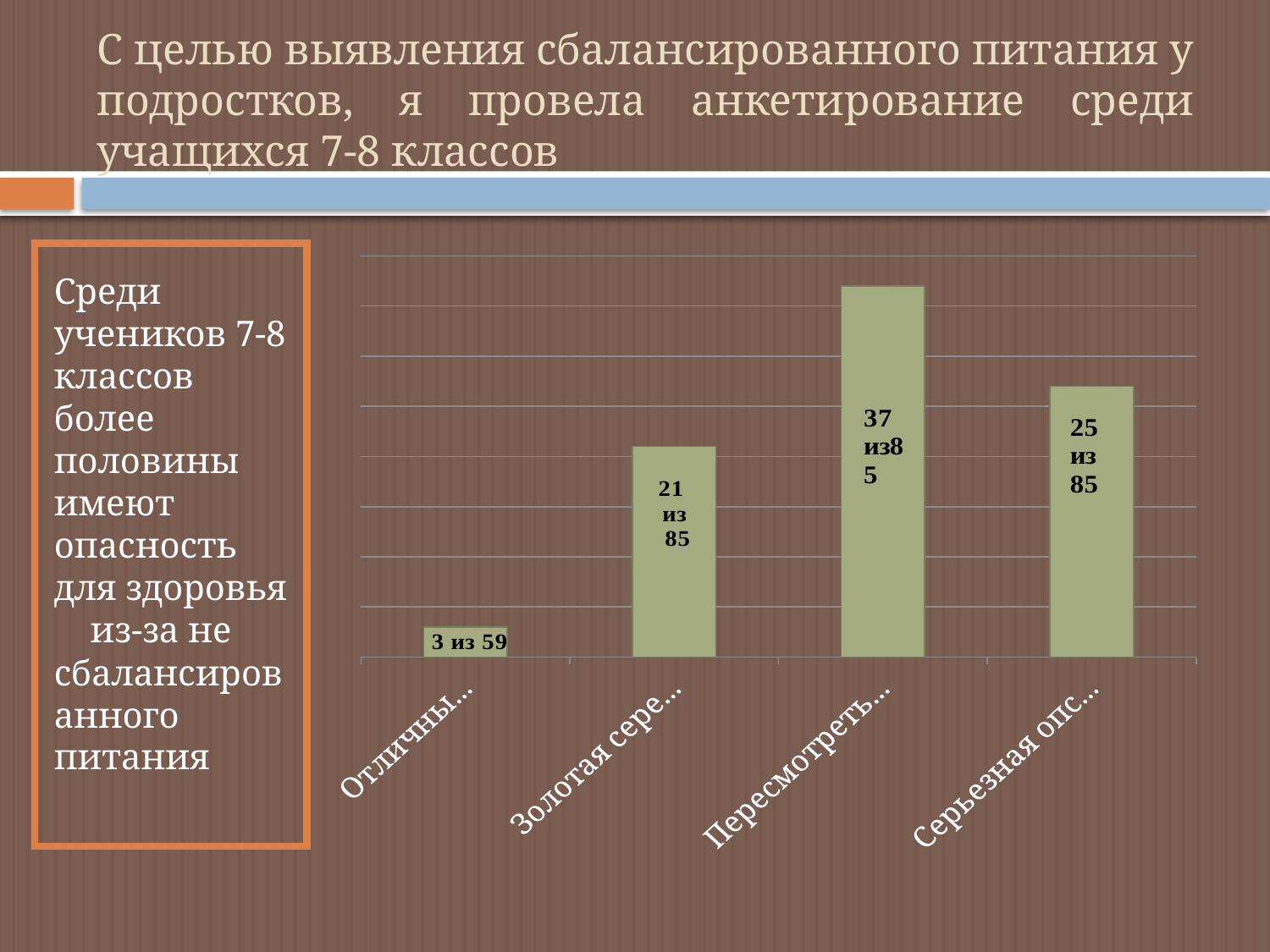
Which category has the shortest bar? Отличны... What kind of chart is shown on the slide? bar chart What colour are the bars in the chart? olive green What is the data label on the bar for the category beginning "Отличны..."? 3 из 59 What is the data label on the bar for the category beginning "Пересмотреть..."? 37 из 85 Which bar is taller: "Золотая сере..." or "Серьезная опс..."? Серьезная опс... Which category has the tallest bar? Пересмотреть... How many bars (categories) does the chart have? 4 What is the data label on the bar for the category beginning "Золотая сере..."? 21 из 85 What is the data label on the bar for the category beginning "Серьезная опс..."? 25 из 85 How many more students are in the "Пересмотреть..." bar (37) than in the "Серьезная опс..." bar (25)? 12 How many more students are in the "Пересмотреть..." bar (37) than in the "Золотая сере..." bar (21)? 16